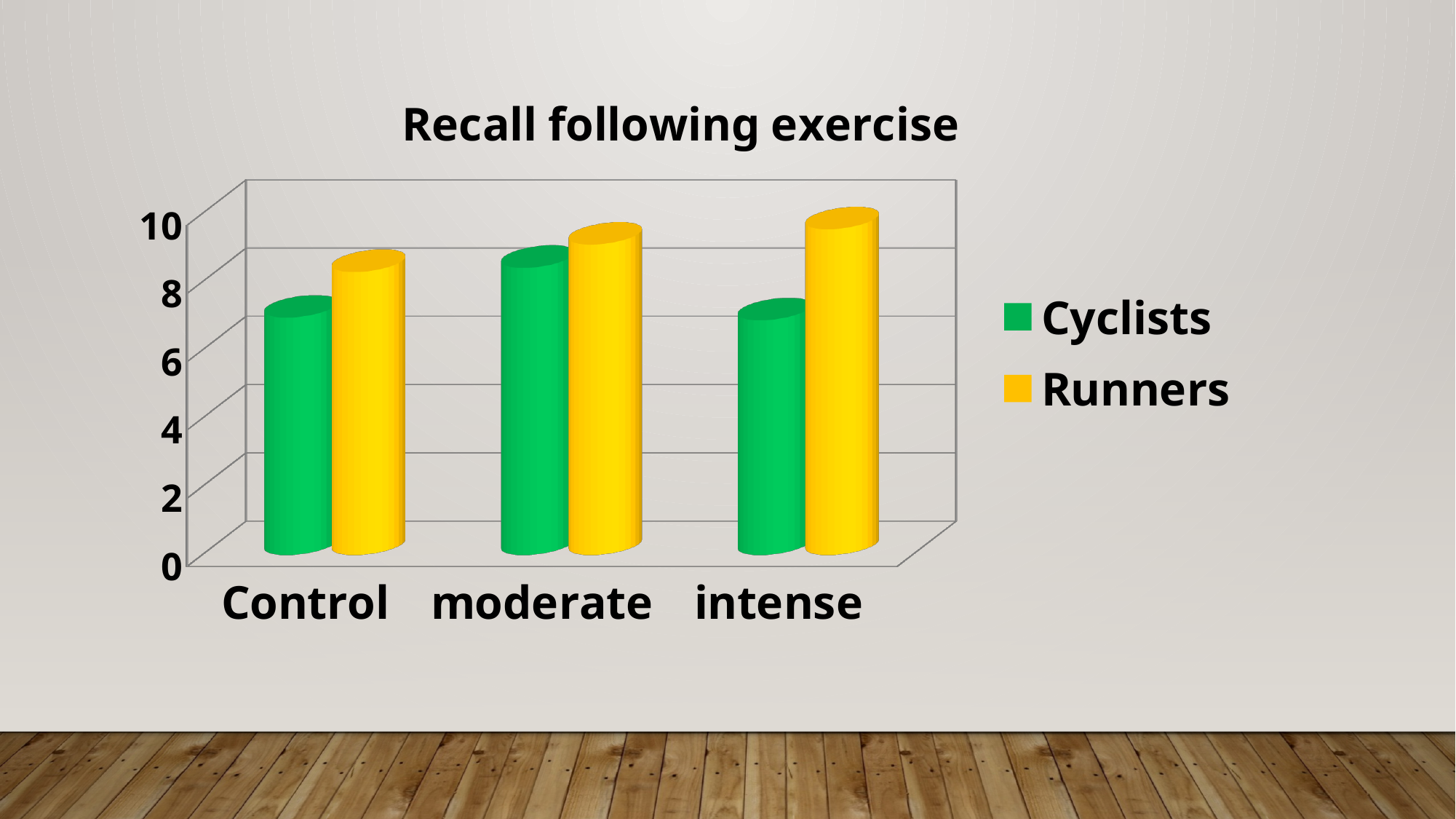
What is the title of the chart? Recall following exercise Which category has the highest value for Cyclists? moderate Do the values for Runners rise or fall from Control to intense? rise Which colour represents Runners in the chart? yellow Which category has the highest value for Runners? intense How many series does the legend list? 2 Is the value for Runners in the intense category greater or less than 8? greater What kind of chart is shown on the slide? bar chart Which category has the lowest value for Runners? Control How many categories are shown on the x axis? 3 Is the value for Cyclists in the intense category greater or less than 4? greater In the intense category, which series has the larger value, Cyclists or Runners? Runners